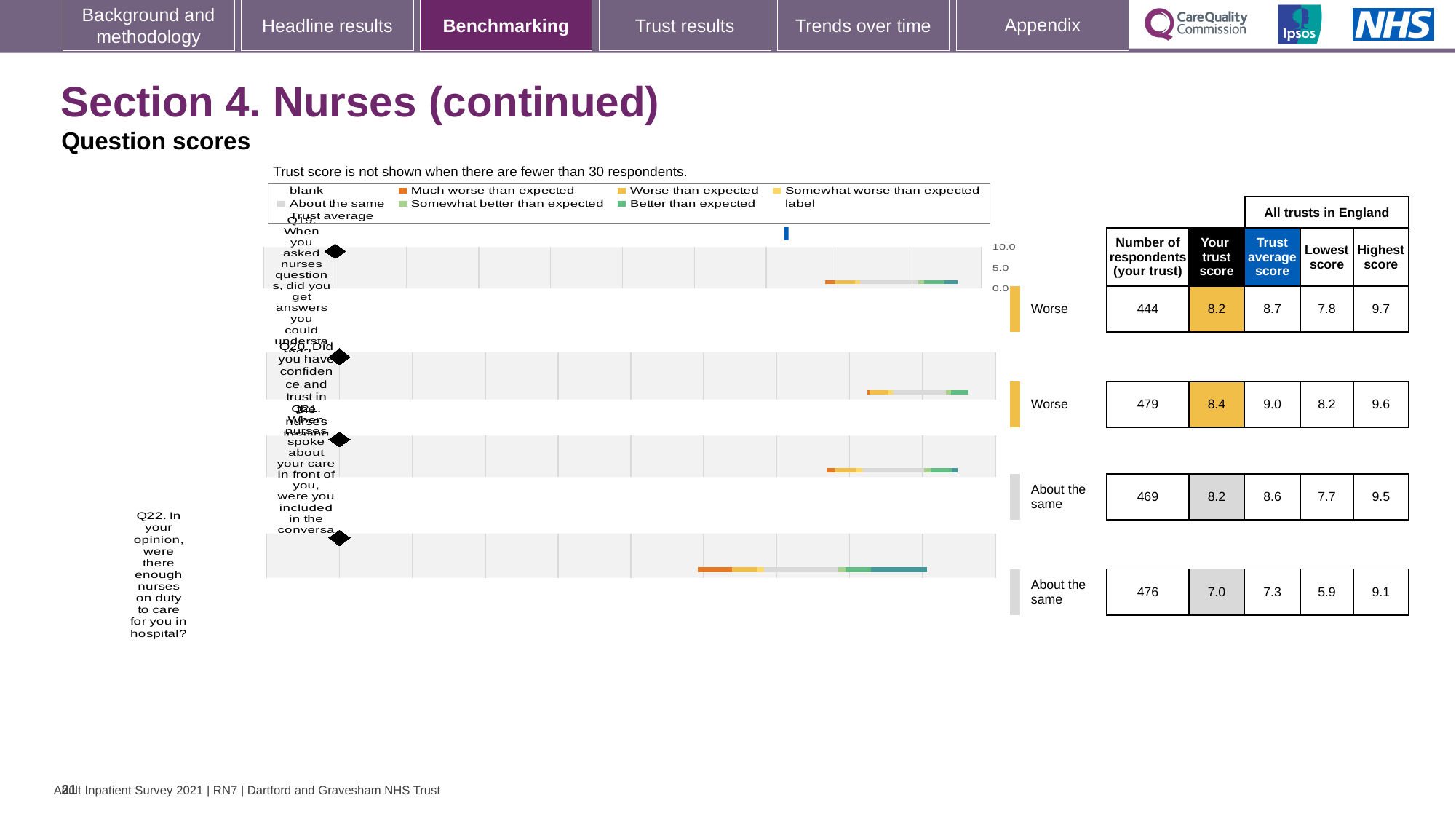
Is the trust score for Q19 higher or lower than the trust average score for Q19? lower Which question has the lowest trust score on this slide? Q22 What is the highest score across all trusts in England for Q21 (were you included in the conversation)? 9.5 How many questions are plotted on this slide? 4 What is the lowest score across all trusts in England for Q22? 5.9 What is the trust average score for Q20 (did you have confidence and trust in the nurses)? 9.0 What is the difference between the trust average score and the trust score for Q20? 0.6 What benchmark category is shown for Q20? Worse How many respondents from the trust answered Q19 (did you get answers you could understand)? 444 What is the trust score for Q22 (were there enough nurses on duty to care for you in hospital)? 7.0 Which question has the highest trust average score on this slide? Q20 What kind of chart is used to show the question scores? bar chart